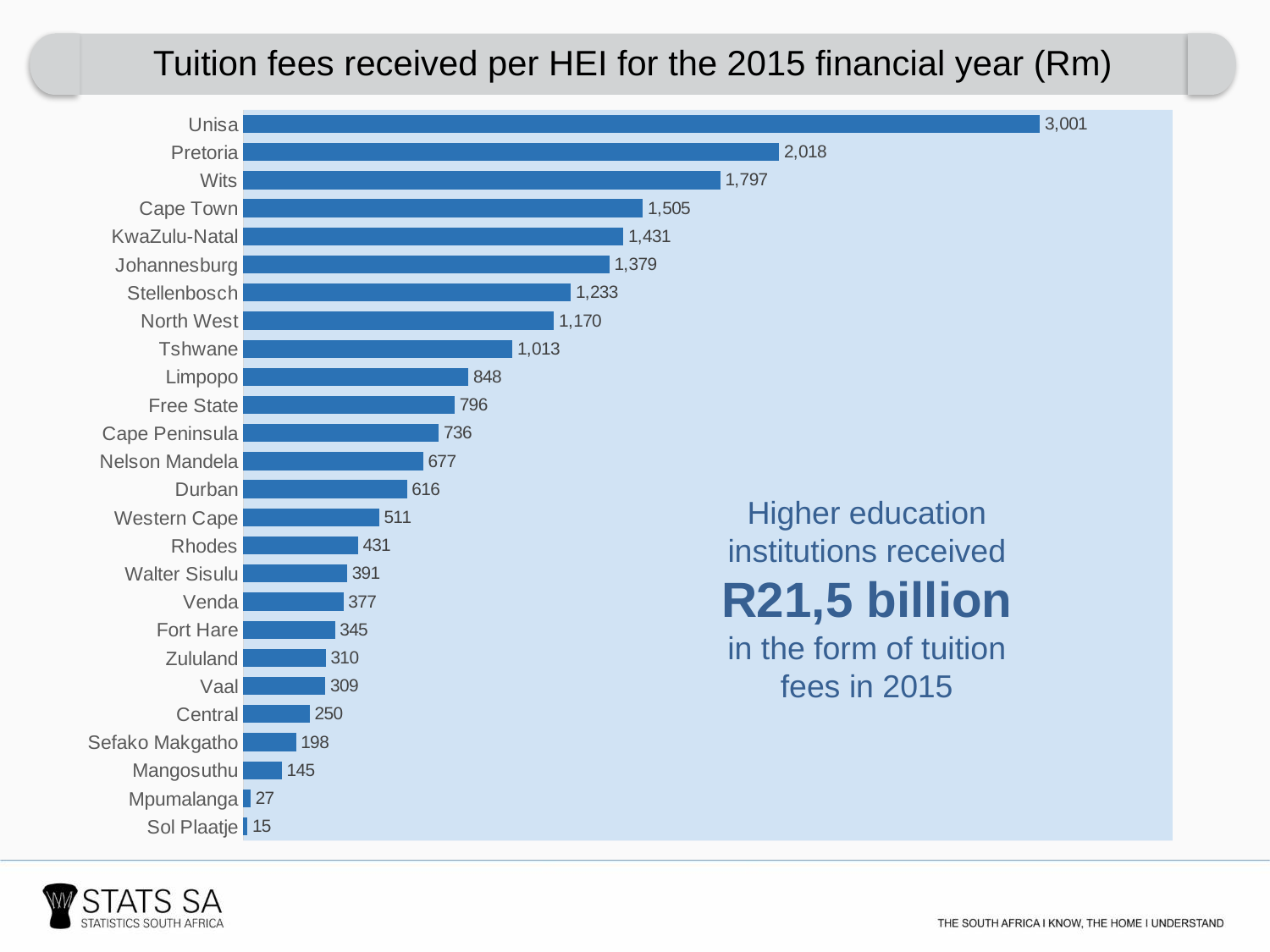
What is the tuition fee value shown for Unisa? 3,001 What kind of chart is shown on the slide? Bar chart According to the text on the chart, how much did higher education institutions receive in tuition fees in 2015? R21,5 billion Which received more tuition fees, Johannesburg or Tshwane? Johannesburg What is the title of the chart? Tuition fees received per HEI for the 2015 financial year (Rm) Which institution received the highest tuition fees? Unisa Which institution received the lowest tuition fees? Sol Plaatje How many institutions are shown in the chart? 26 What is the tuition fee value shown for Mangosuthu? 145 What is the difference between the tuition fees for Unisa and Pretoria? 983 What is the tuition fee value shown for Stellenbosch? 1,233 What is the difference between the tuition fees for Wits and Cape Town? 292